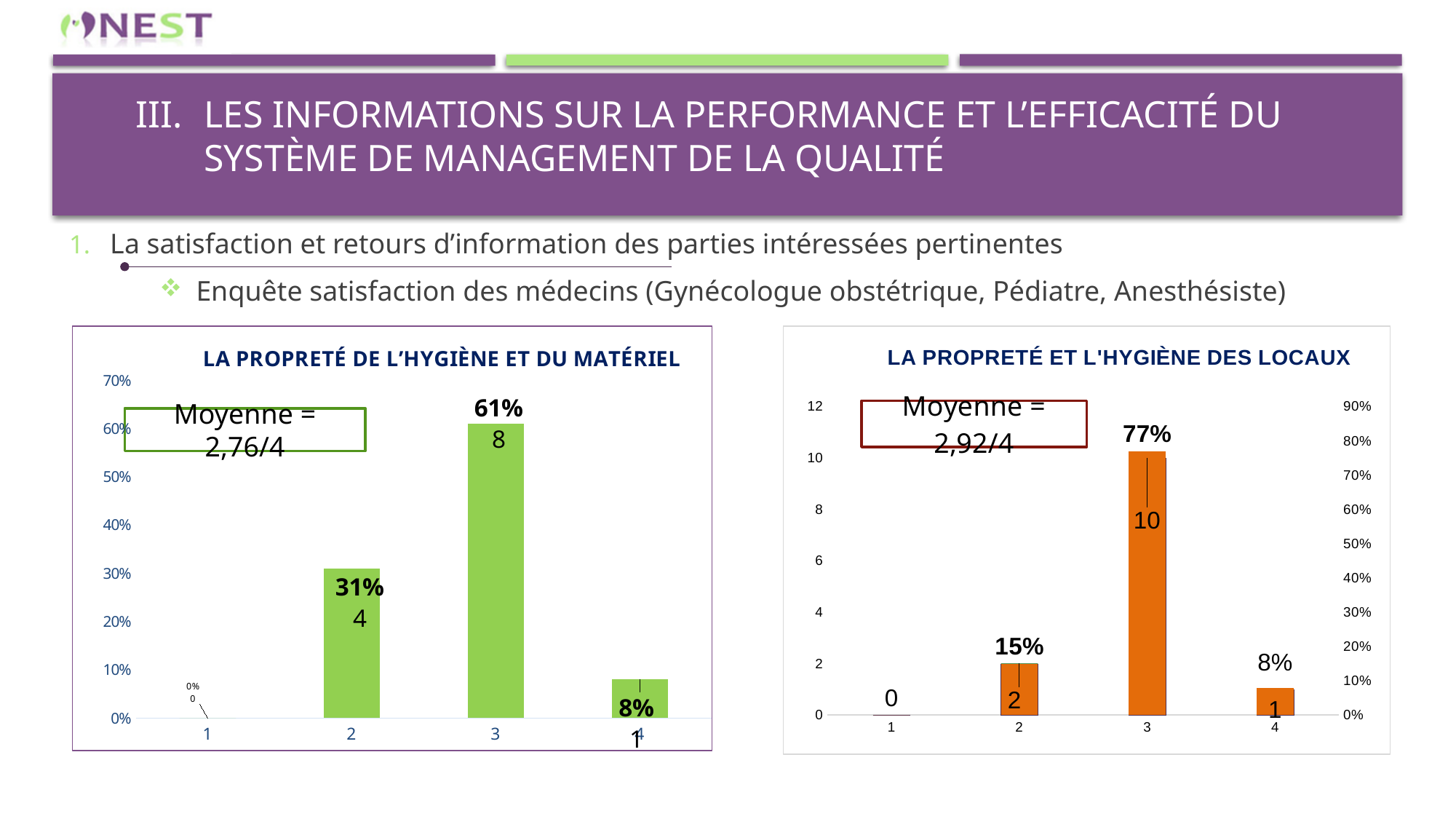
In the chart titled "LA PROPRETÉ ET L'HYGIÈNE DES LOCAUX", what count is labelled on the bar for category 3? 10 In the chart titled "LA PROPRETÉ DE L'HYGIÈNE ET DU MATÉRIEL", what percentage is shown for category 3? 61% In the chart titled "LA PROPRETÉ DE L'HYGIÈNE ET DU MATÉRIEL", which category has the lowest value? 1 In the chart titled "LA PROPRETÉ DE L'HYGIÈNE ET DU MATÉRIEL", what count is labelled on the bar for category 2? 4 In the chart titled "LA PROPRETÉ DE L'HYGIÈNE ET DU MATÉRIEL", what kind of chart is shown? bar chart In the chart titled "LA PROPRETÉ ET L'HYGIÈNE DES LOCAUX", what percentage is shown for category 2? 15% In the chart titled "LA PROPRETÉ DE L'HYGIÈNE ET DU MATÉRIEL", what is the difference in percentage points between category 3 and category 2? 30 In the chart titled "LA PROPRETÉ ET L'HYGIÈNE DES LOCAUX", which is larger, the value for category 2 or category 4? category 2 In the chart titled "LA PROPRETÉ DE L'HYGIÈNE ET DU MATÉRIEL", which category has the highest value? 3 In the chart titled "LA PROPRETÉ ET L'HYGIÈNE DES LOCAUX", what average (Moyenne) is shown in the box? 2,92/4 In the chart titled "LA PROPRETÉ ET L'HYGIÈNE DES LOCAUX", which category has the highest value? 3 In the chart titled "LA PROPRETÉ ET L'HYGIÈNE DES LOCAUX", how many categories are shown on the x axis? 4